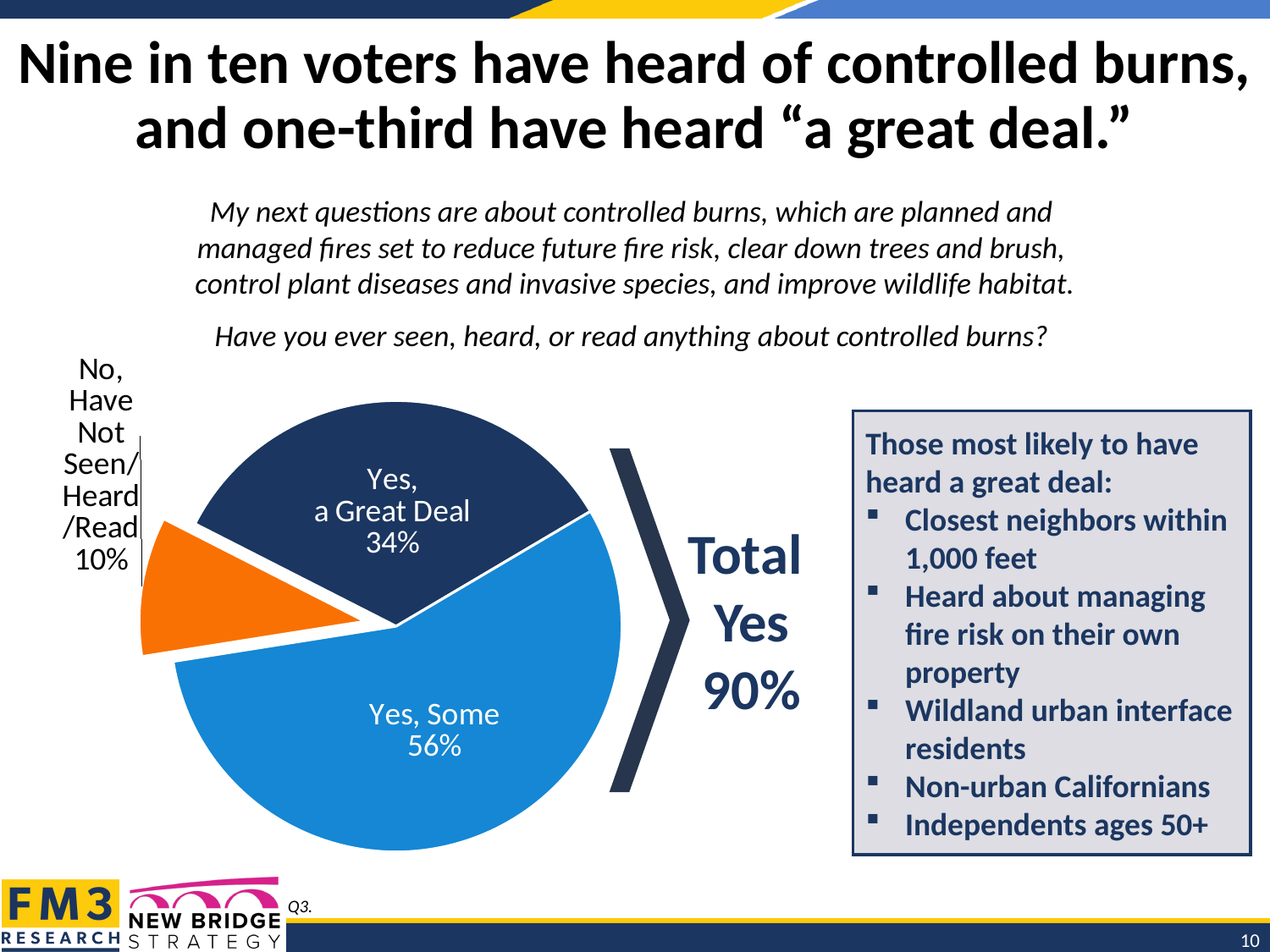
Which is larger: "Yes, a Great Deal" or "No, Have Not Seen/Heard/Read"? Yes, a Great Deal What kind of chart is shown on the slide? Pie chart What label is shown next to the bracket to the right of the pie chart? Total Yes 90% Which slice of the pie is the smallest? No, Have Not Seen/Heard/Read What is the difference between the "Yes, Some" and "Yes, a Great Deal" percentages? 22 percentage points What colour is the "Yes, Some" slice? Light blue How many slices does the pie chart have? 3 What percentage of voters said "Yes, a Great Deal"? 34% What percentage of voters said "Yes, Some"? 56% Which slice of the pie is the largest? Yes, Some What is the combined share of the two "Yes" slices? 90% What percentage of voters said "No, Have Not Seen/Heard/Read"? 10%